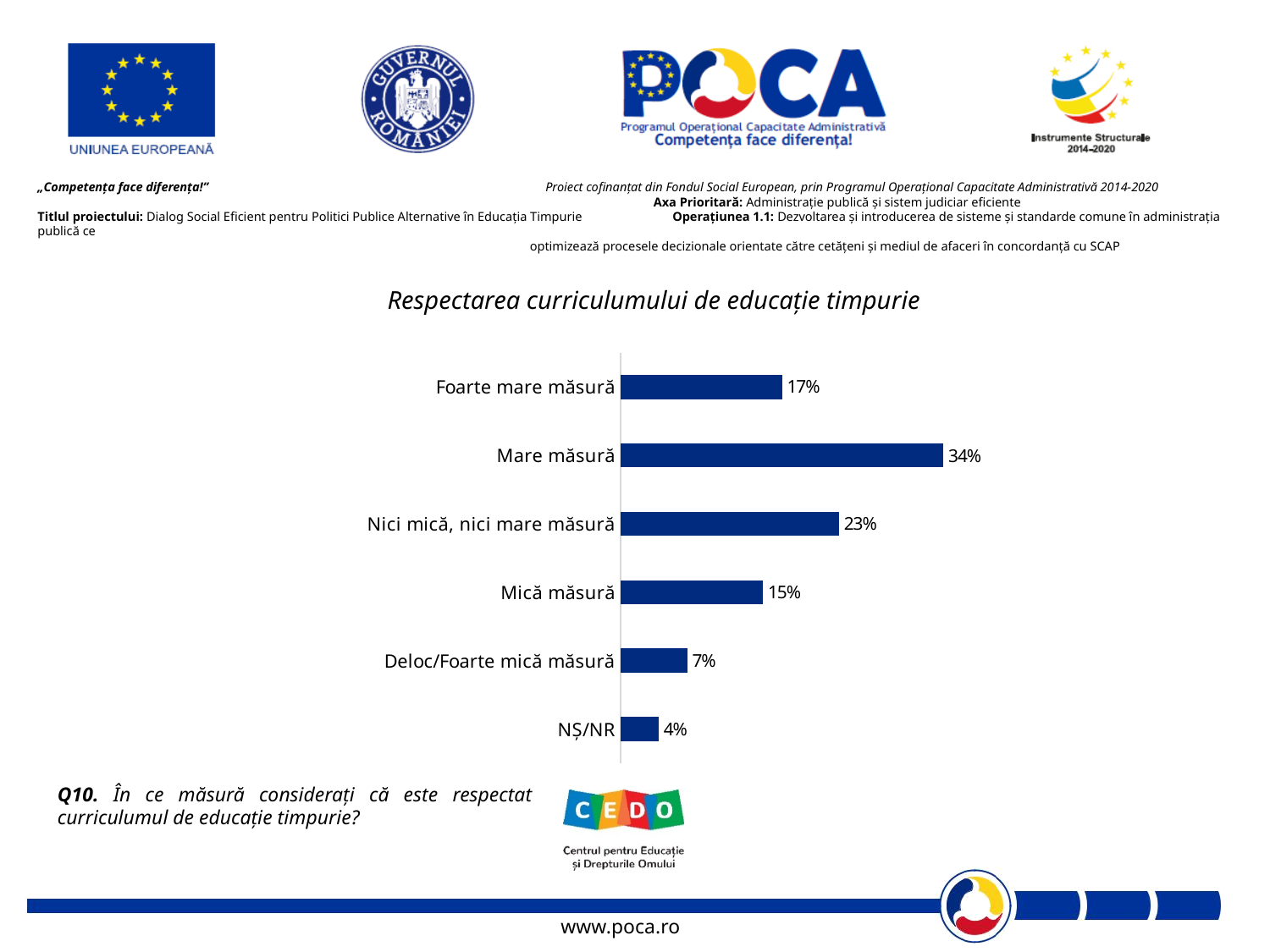
What is the value for "Mică măsură"? 15% Which category has the lowest value? NȘ/NR Which is larger, the value for "Foarte mare măsură" or the value for "Mică măsură"? Foarte mare măsură How many categories are shown in the chart? 6 What is the difference between the values for "Mare măsură" and "Foarte mare măsură"? 17% What is the title of the chart? Respectarea curriculumului de educație timpurie What is the value for "Mare măsură"? 34% What is the value for "Nici mică, nici mare măsură"? 23% What is the value for "NȘ/NR"? 4% What kind of chart is shown on the slide? Bar chart What is the difference between the values for "Deloc/Foarte mică măsură" and "NȘ/NR"? 3% Which category has the highest value? Mare măsură